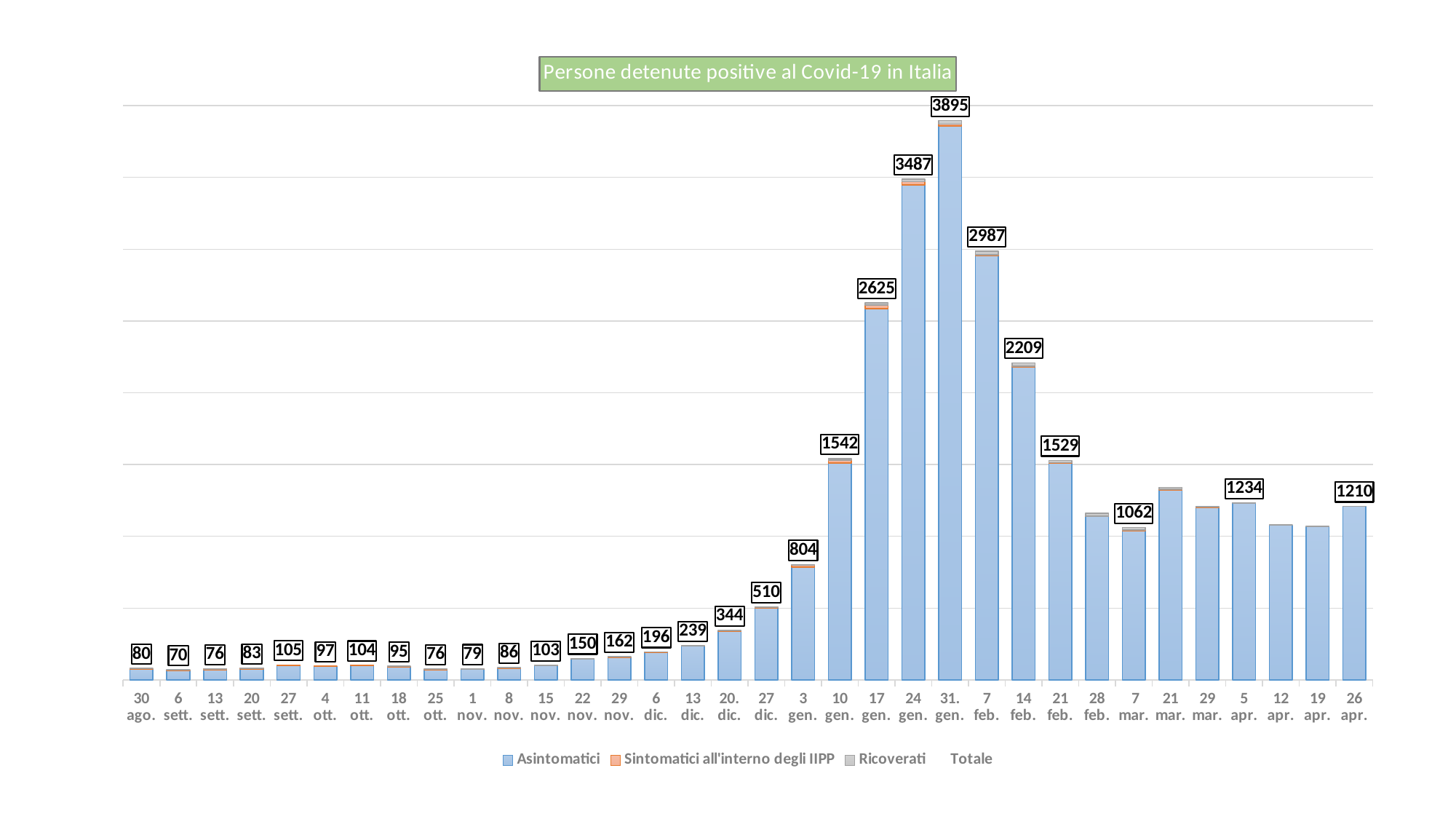
What is the title of the chart? Persone detenute positive al Covid-19 in Italia Which is larger, the total for 7 feb. or the total for 14 feb.? 7 feb. What is the total value labelled for 31 gen.? 3895 What is the difference between the total for 10 gen. and the total for 3 gen.? 738 What is the total value labelled for 3 gen.? 804 Which date has the lowest total value? 6 sett. What is the difference between the total for 31 gen. and the total for 24 gen.? 408 What is the total value labelled for 24 gen.? 3487 Which date has the highest total value? 31 gen. How many series does the legend list? 4 What is the total value labelled for 26 apr.? 1210 What kind of chart is shown on the slide? bar chart